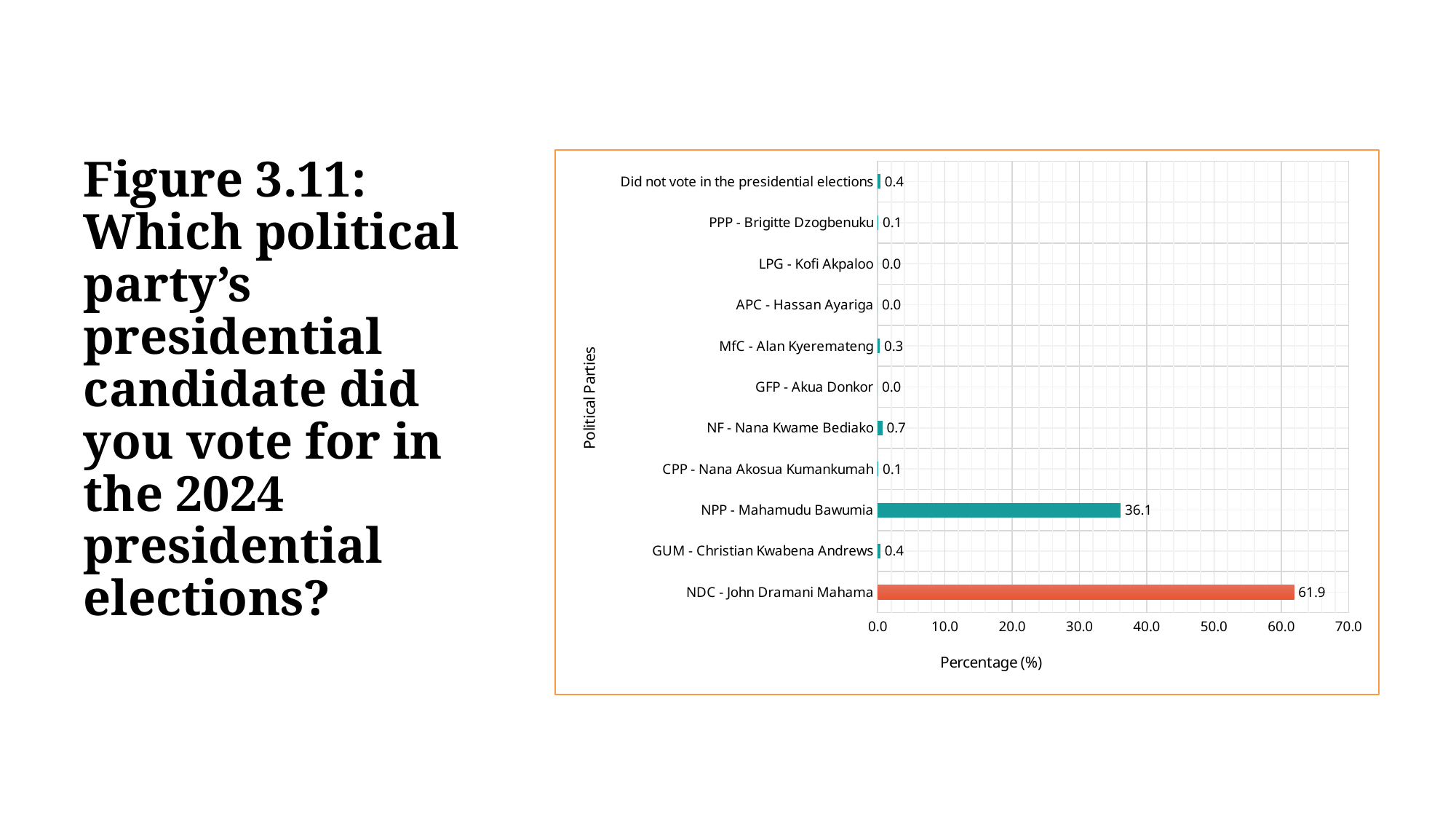
How many categories have a value of 0.0? 3 Which is larger, the value for MfC - Alan Kyeremateng or the value for NF - Nana Kwame Bediako? NF - Nana Kwame Bediako What is the label of the horizontal axis? Percentage (%) What is the difference between the values for NDC - John Dramani Mahama and NPP - Mahamudu Bawumia? 25.8 Is the value for NPP - Mahamudu Bawumia greater or less than 40.0? less Which category has the highest value? NDC - John Dramani Mahama How many categories are shown on the chart? 11 What percentage of respondents voted for NDC - John Dramani Mahama? 61.9 What percentage did not vote in the presidential elections? 0.4 What is the value for NF - Nana Kwame Bediako? 0.7 What is the value shown for NPP - Mahamudu Bawumia? 36.1 What kind of chart is shown on the slide? bar chart